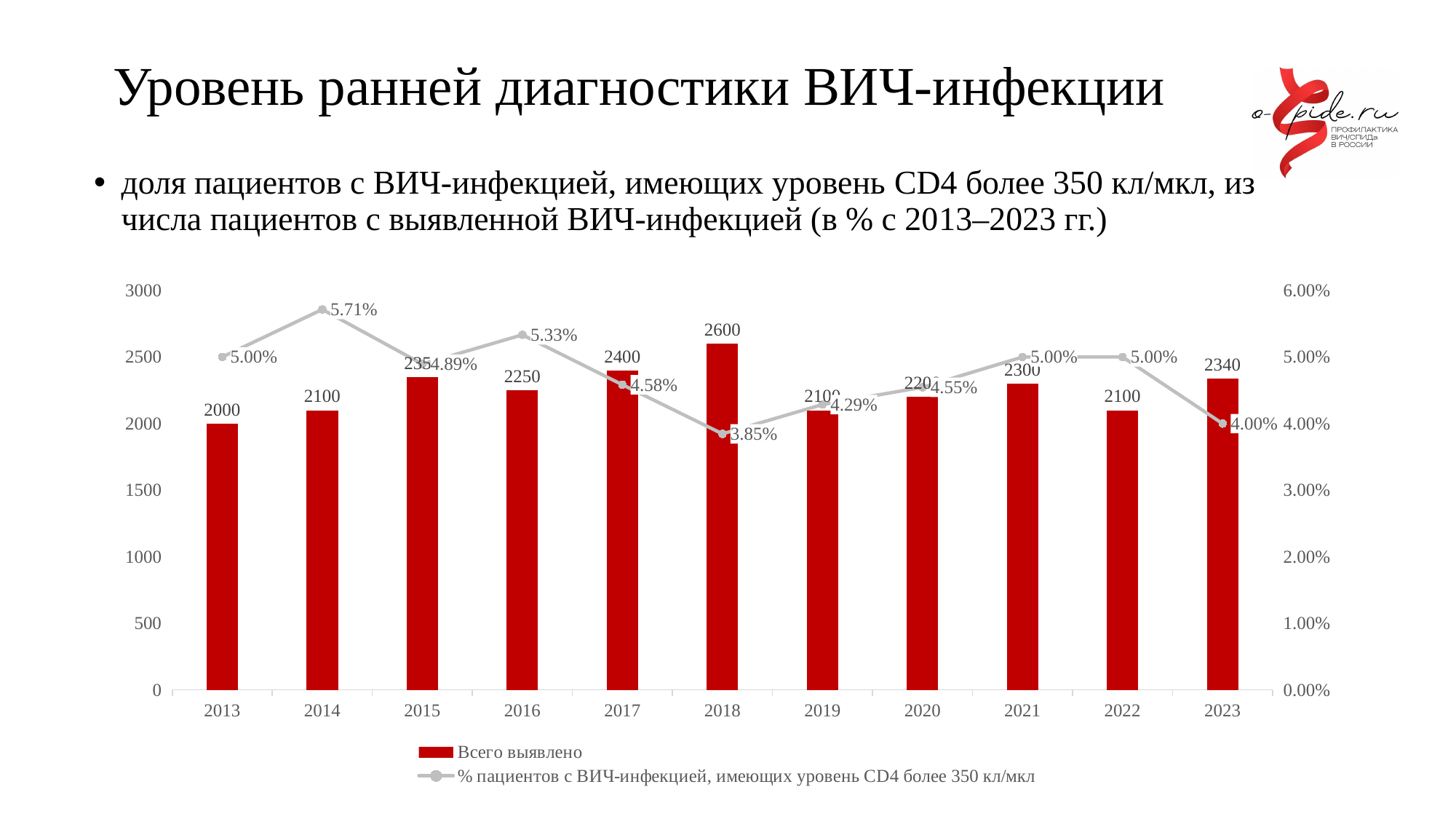
What colour are the "Всего выявлено" bars? Red Which year has a larger "Всего выявлено" value, 2017 or 2021? 2017 In which year is the "Всего выявлено" bar the lowest? 2013 In which year is the "Всего выявлено" bar the highest? 2018 What is the difference between the "Всего выявлено" values for 2018 and 2013? 600 What percentage of patients with CD4 above 350 кл/мкл is shown for 2014? 5.71% In which year is the percentage of patients with CD4 above 350 кл/мкл the lowest? 2018 How many years are shown on the x axis? 11 What is the value of "Всего выявлено" for 2023? 2340 What percentage of patients with CD4 above 350 кл/мкл is shown for 2018? 3.85% How many series does the legend list? 2 What is the value of "Всего выявлено" for 2018? 2600